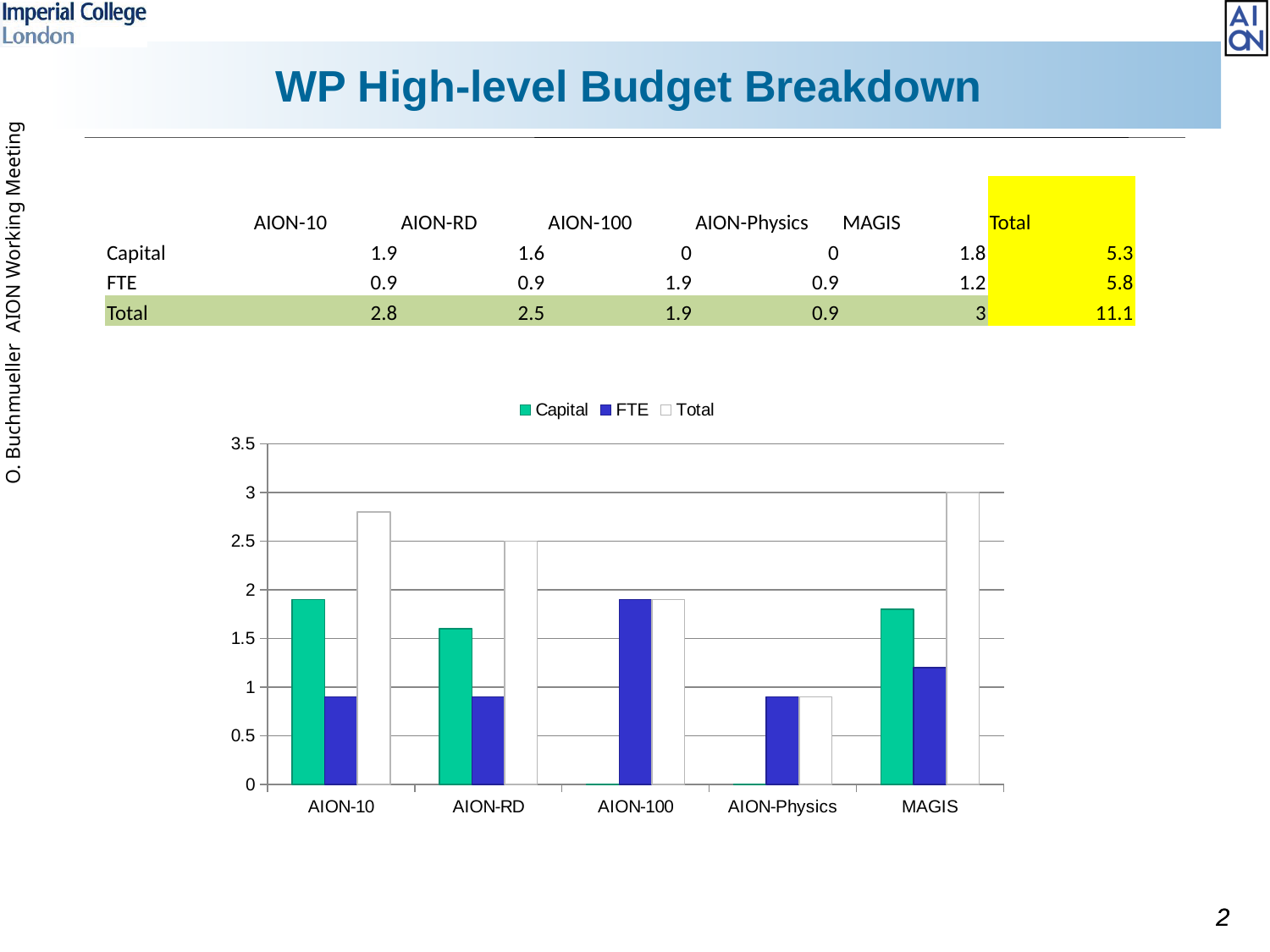
How many categories are shown along the x axis of the chart? 5 Is the Total value for MAGIS greater or less than 2.5? greater What is the Capital value for AION-10? 1.9 Is the FTE value for AION-Physics greater or less than 1? less What kind of chart is shown on the slide? bar chart Which category has the highest Total value? MAGIS How many series does the chart legend list? 3 Which has the larger Capital value, AION-10 or AION-RD? AION-10 Which category has the lowest Total value? AION-Physics What is the difference between the Total value for AION-10 and the Total value for AION-RD? 0.3 What is the FTE value for AION-100? 1.9 What are the three series named in the chart legend? Capital, FTE, Total